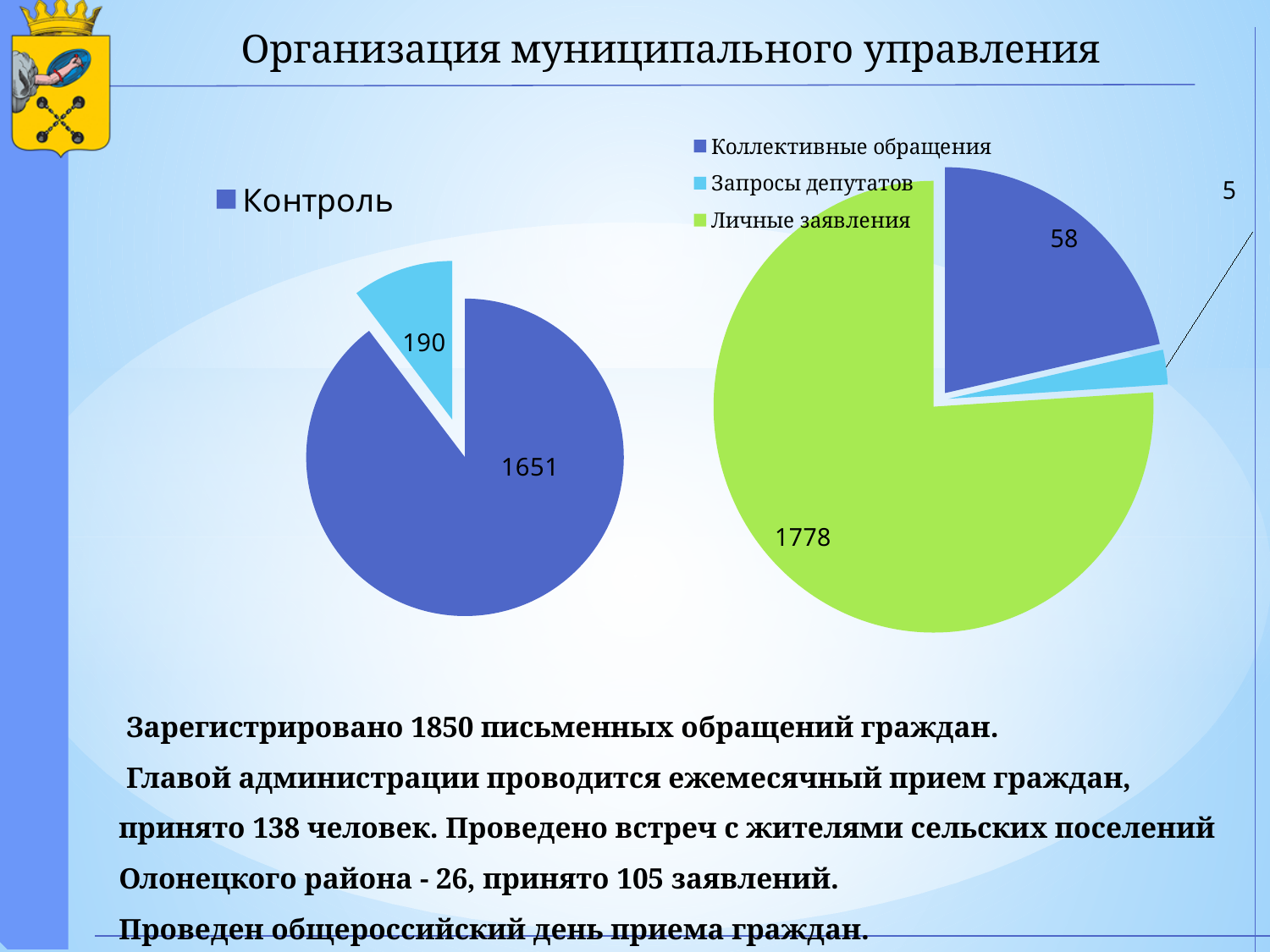
On the right pie chart, which category has the largest slice? Личные заявления On the right pie chart, what is the value for Личные заявления? 1778 What type of chart is the left chart on the slide? Pie chart On the right pie chart, which category has the smallest slice? Запросы депутатов On the left pie chart, what is the value of the dark blue slice labelled Контроль in the legend? 1651 On the left pie chart, what is the value of the smaller, light blue slice? 190 On the right pie chart, which is larger: Коллективные обращения or Запросы депутатов? Коллективные обращения How many entries does the legend of the right pie chart list? 3